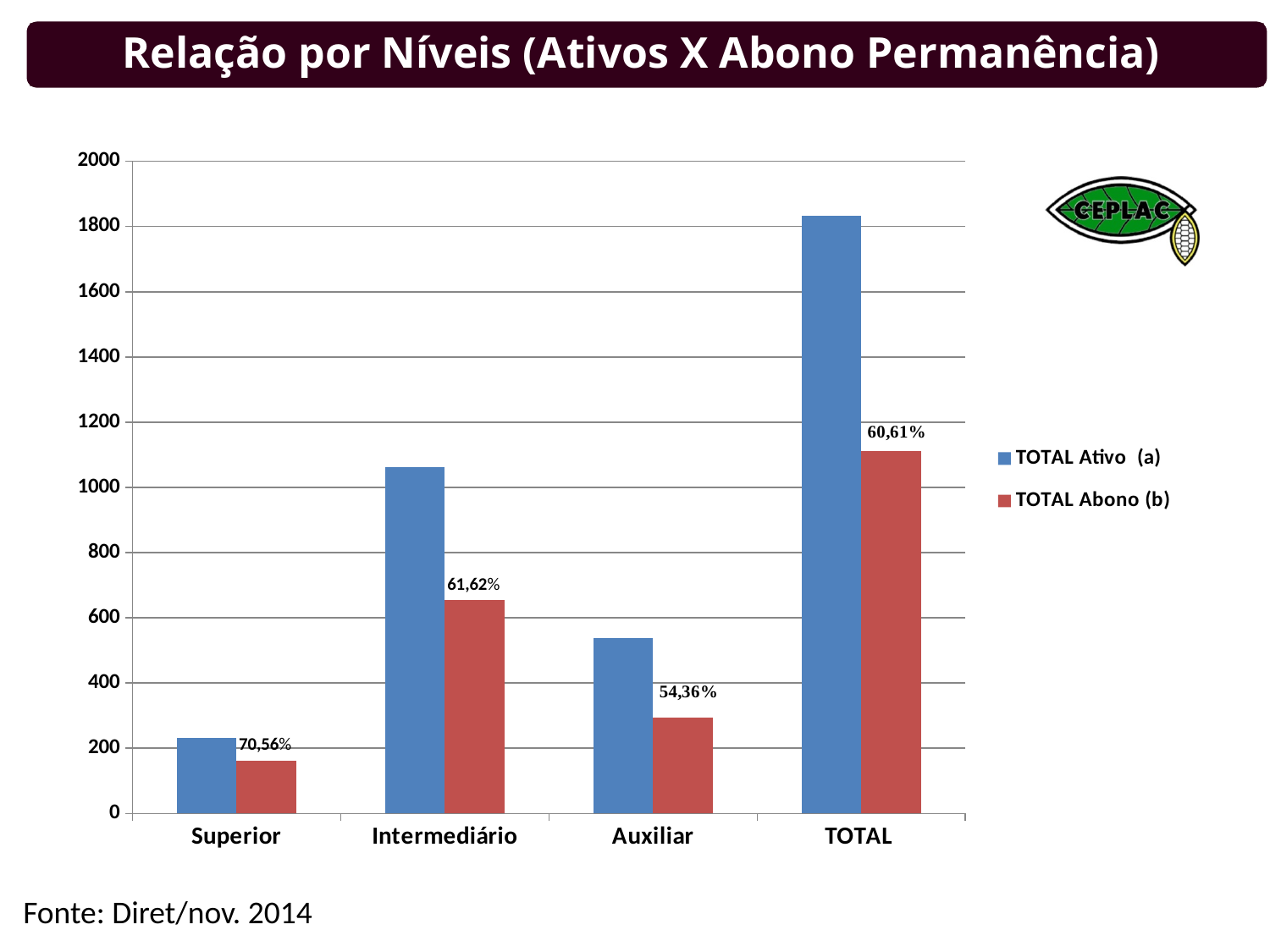
Which category has the highest percentage label? Superior What percentage label is shown for the Intermediário category? 61,62% Is the TOTAL Ativo (a) value for Intermediário greater or less than 1000? greater How many series does the chart's legend list? 2 What percentage label is shown for the Superior category? 70,56% What percentage label is shown for the TOTAL category? 60,61% Which is larger, the TOTAL Ativo (a) value for Intermediário or for Auxiliar? Intermediário What percentage label is shown for the Auxiliar category? 54,36% Is the TOTAL Ativo (a) value for Auxiliar greater or less than 600? less How many categories are shown on the x axis of the chart? 4 Which category has the lowest percentage label? Auxiliar What kind of chart is shown on the slide? bar chart